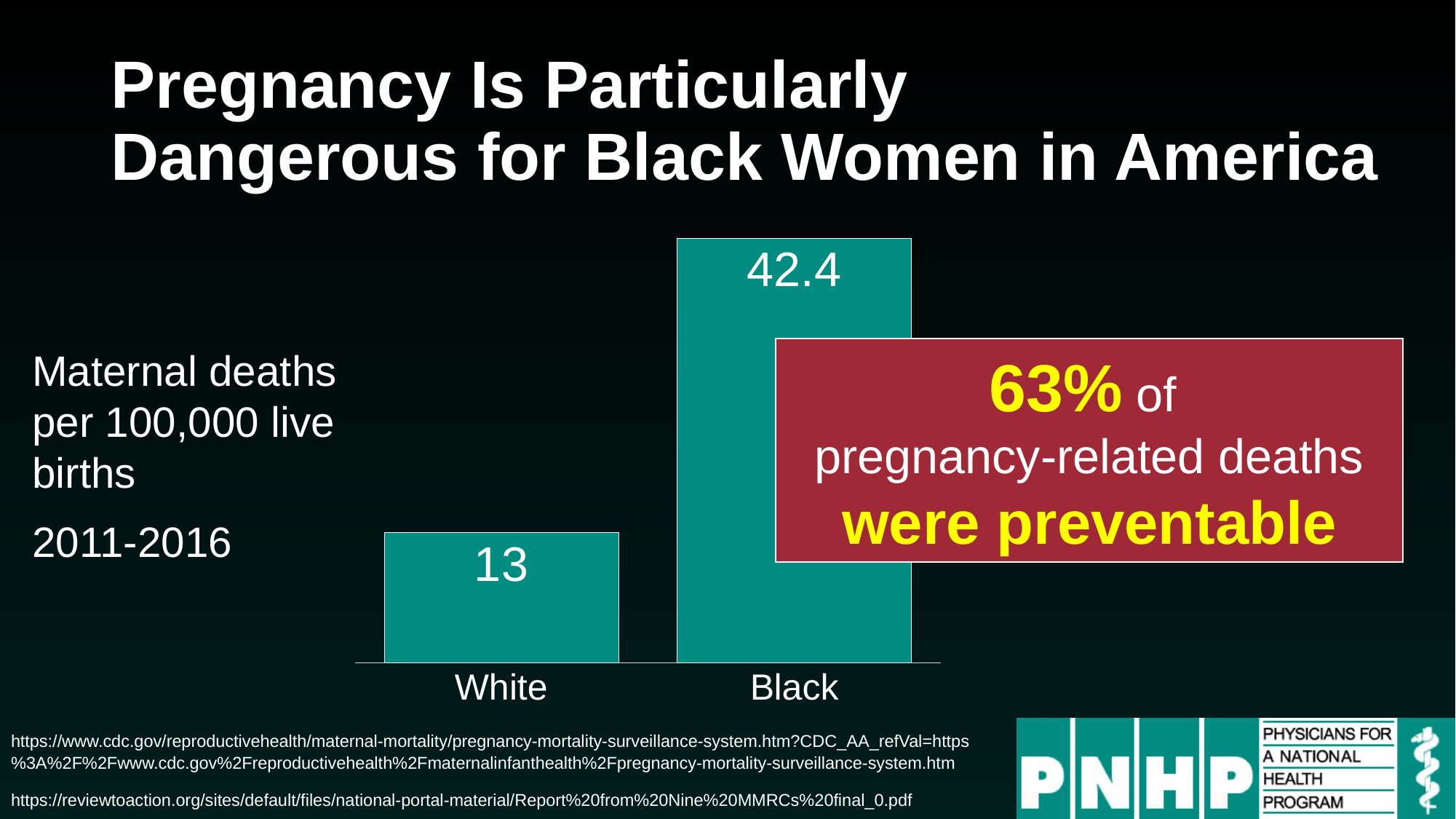
Is the maternal death rate for Black women larger or smaller than that for White women? larger Which group has the lower maternal death rate? White Which group has the higher maternal death rate? Black How many categories are shown on the chart? 2 What is the difference between the maternal death rates for Black and White women? 29.4 What kind of chart is shown on the slide? bar chart What is the maternal death rate per 100,000 live births for Black women? 42.4 What is the maternal death rate per 100,000 live births for White women? 13 What colour are the bars in the chart? teal What time period does the chart cover? 2011-2016